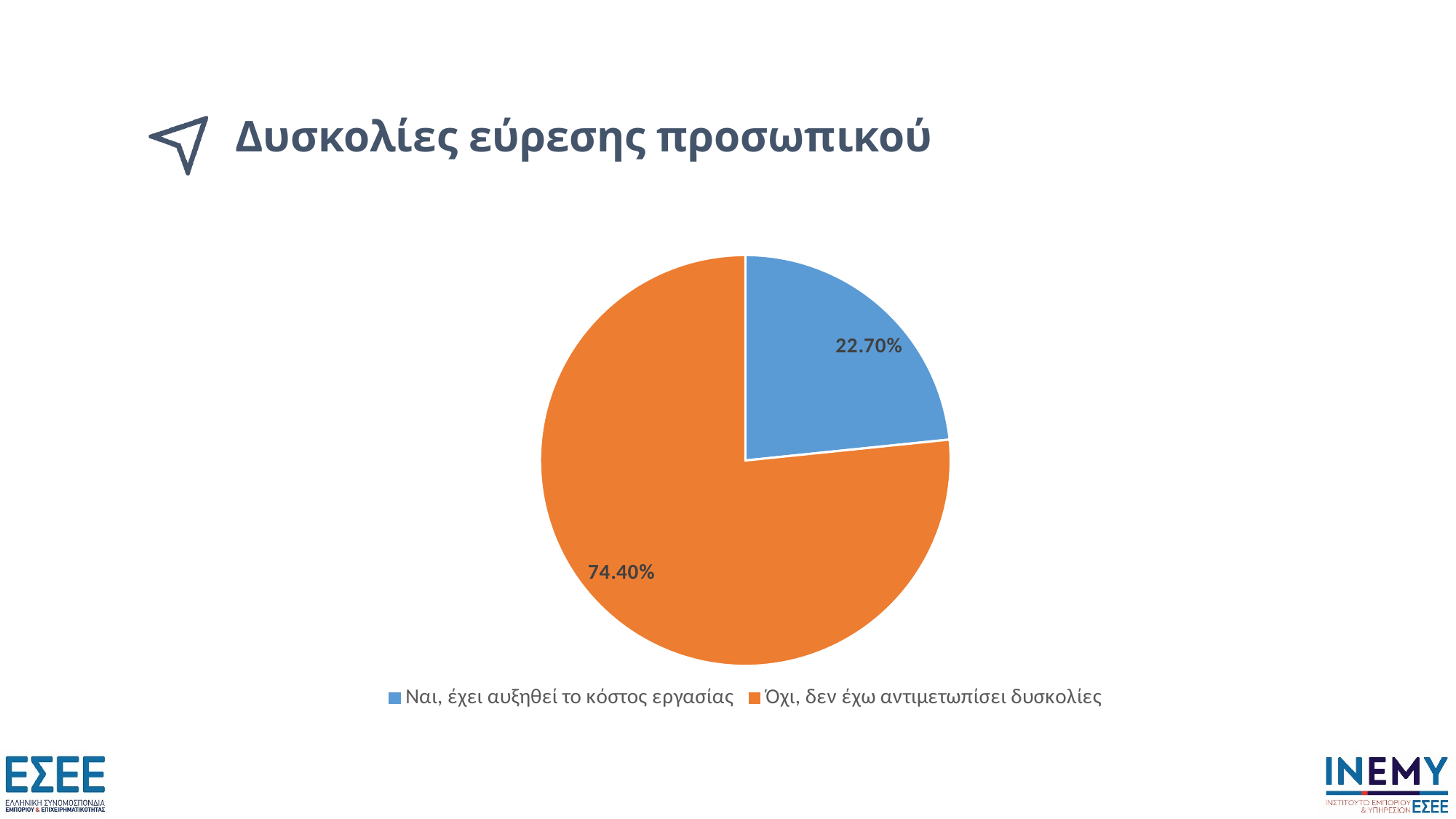
What colour is the slice for "Όχι, δεν έχω αντιμετωπίσει δυσκολίες"? orange How many entries does the legend list? 2 Which is larger: the slice for "Ναι, έχει αυξηθεί το κόστος εργασίας" or the slice for "Όχι, δεν έχω αντιμετωπίσει δυσκολίες"? Όχι, δεν έχω αντιμετωπίσει δυσκολίες Which category has the smallest slice of the pie? Ναι, έχει αυξηθεί το κόστος εργασίας What is the value for "Όχι, δεν έχω αντιμετωπίσει δυσκολίες"? 74.40% How many slices does the pie chart have? 2 What is the title of the slide? Δυσκολίες εύρεσης προσωπικού Which category has the largest slice of the pie? Όχι, δεν έχω αντιμετωπίσει δυσκολίες What kind of chart is shown on the slide? pie chart What is the value for "Ναι, έχει αυξηθεί το κόστος εργασίας"? 22.70% What is the difference between the values for "Όχι, δεν έχω αντιμετωπίσει δυσκολίες" and "Ναι, έχει αυξηθεί το κόστος εργασίας"? 51.70%